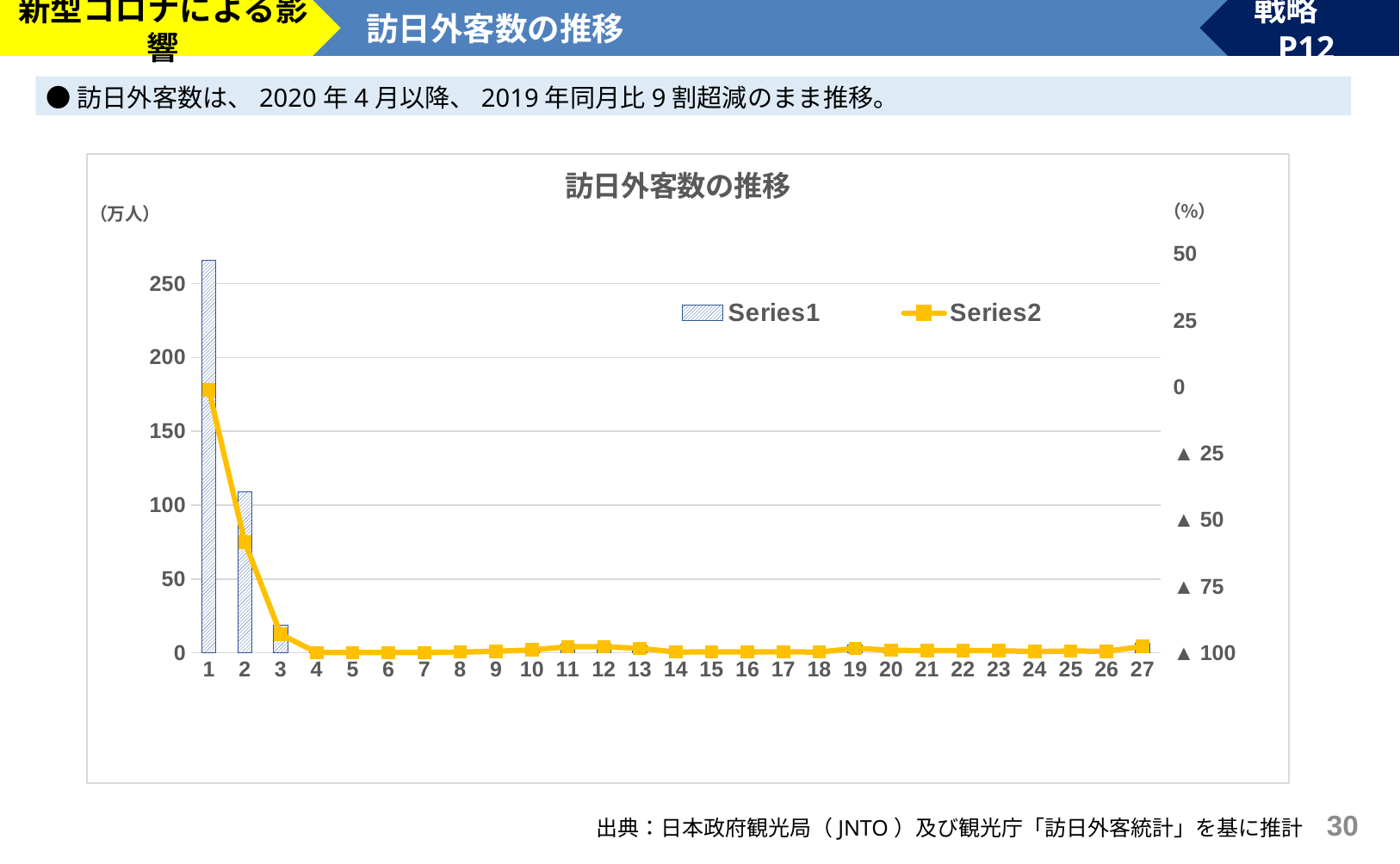
Is the Series1 value for category 1 greater or less than 250? greater What is the title of the chart? 訪日外客数の推移 What kind of chart is shown on the slide? A combined bar and line chart Is the Series1 value for category 2 greater or less than 100? greater Do the Series1 bars rise or fall from category 1 to category 4? Fall How many categories are shown on the x axis? 27 What unit is shown on the left vertical axis? 万人 Which category has the highest Series1 bar? 1 How many series does the legend list? 2 Is the Series1 value for category 3 greater or less than 50? less Which is larger, the Series1 value for category 1 or for category 2? Category 1 Which series is drawn as a line with square markers? Series2